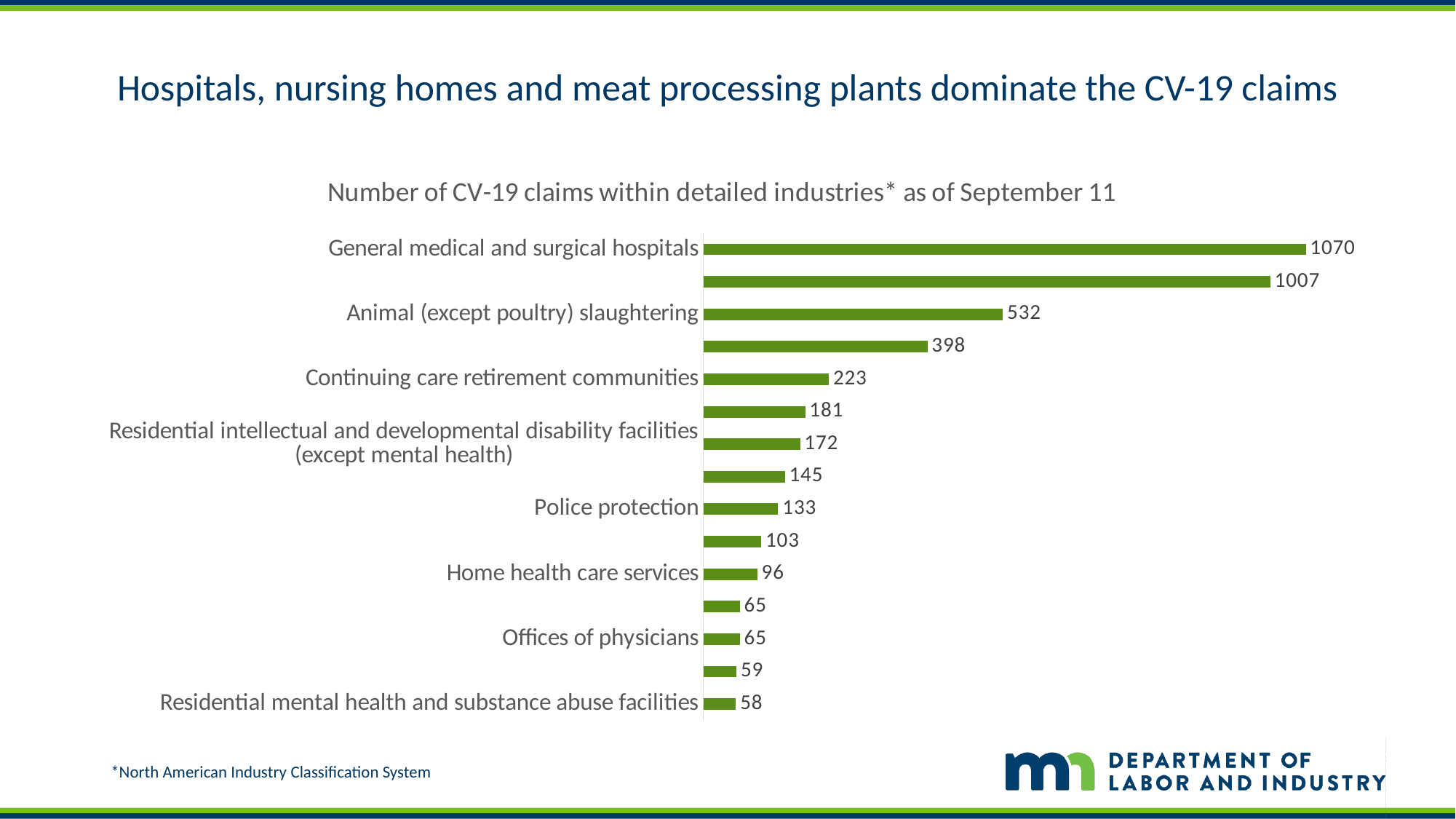
What is the number of CV-19 claims for General medical and surgical hospitals? 1070 How many bars are plotted in the chart? 15 What is the number of CV-19 claims for Home health care services? 96 What is the number of CV-19 claims for Continuing care retirement communities? 223 How many more CV-19 claims do General medical and surgical hospitals have than Animal (except poultry) slaughtering? 538 Which labeled industry has the highest number of CV-19 claims? General medical and surgical hospitals What kind of chart is shown on the slide? Bar chart What is the number of CV-19 claims for Police protection? 133 Which labeled industry has the lowest number of CV-19 claims? Residential mental health and substance abuse facilities Which has more CV-19 claims, Police protection or Home health care services? Police protection What is the difference in CV-19 claims between Continuing care retirement communities and Police protection? 90 What is the number of CV-19 claims for Animal (except poultry) slaughtering? 532